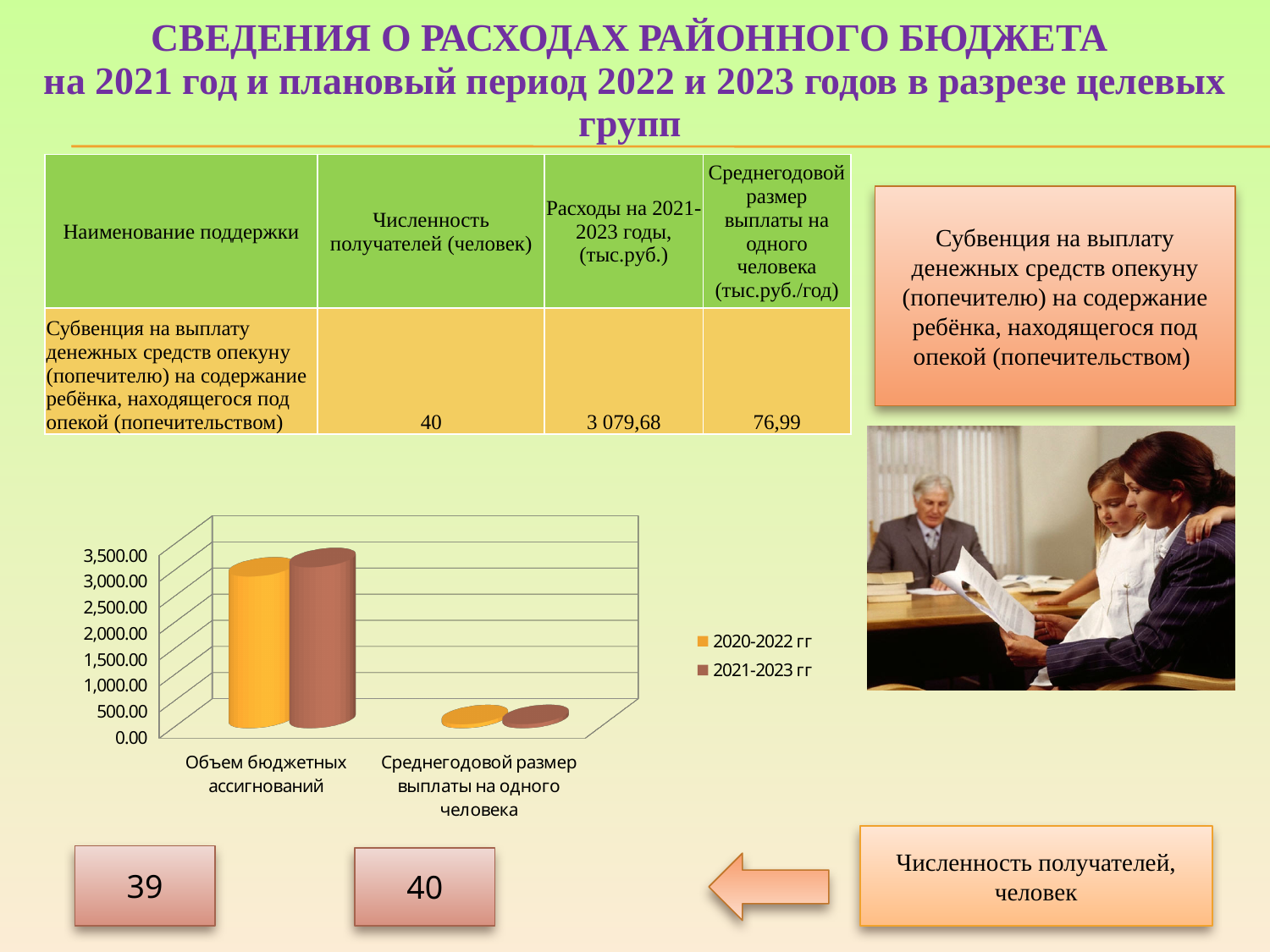
How many series does the chart legend list? 2 In the 2021-2023 гг series, which is larger: Объем бюджетных ассигнований or Среднегодовой размер выплаты на одного человека? Объем бюджетных ассигнований How many categories are shown on the x axis of the chart? 2 Is the value for Среднегодовой размер выплаты на одного человека in the 2021-2023 гг series greater or less than 500.00? less What is the highest value shown on the chart's vertical axis? 3,500.00 Is the value for Объем бюджетных ассигнований in the 2021-2023 гг series greater or less than 2,500.00? greater Is the value for Объем бюджетных ассигнований in the 2020-2022 гг series greater or less than 3,500.00? less Which category has the highest bars in the chart? Объем бюджетных ассигнований Which category has the lowest bars in the chart? Среднегодовой размер выплаты на одного человека What are the two series names listed in the chart legend? 2020-2022 гг and 2021-2023 гг What kind of chart is shown on the slide? bar chart